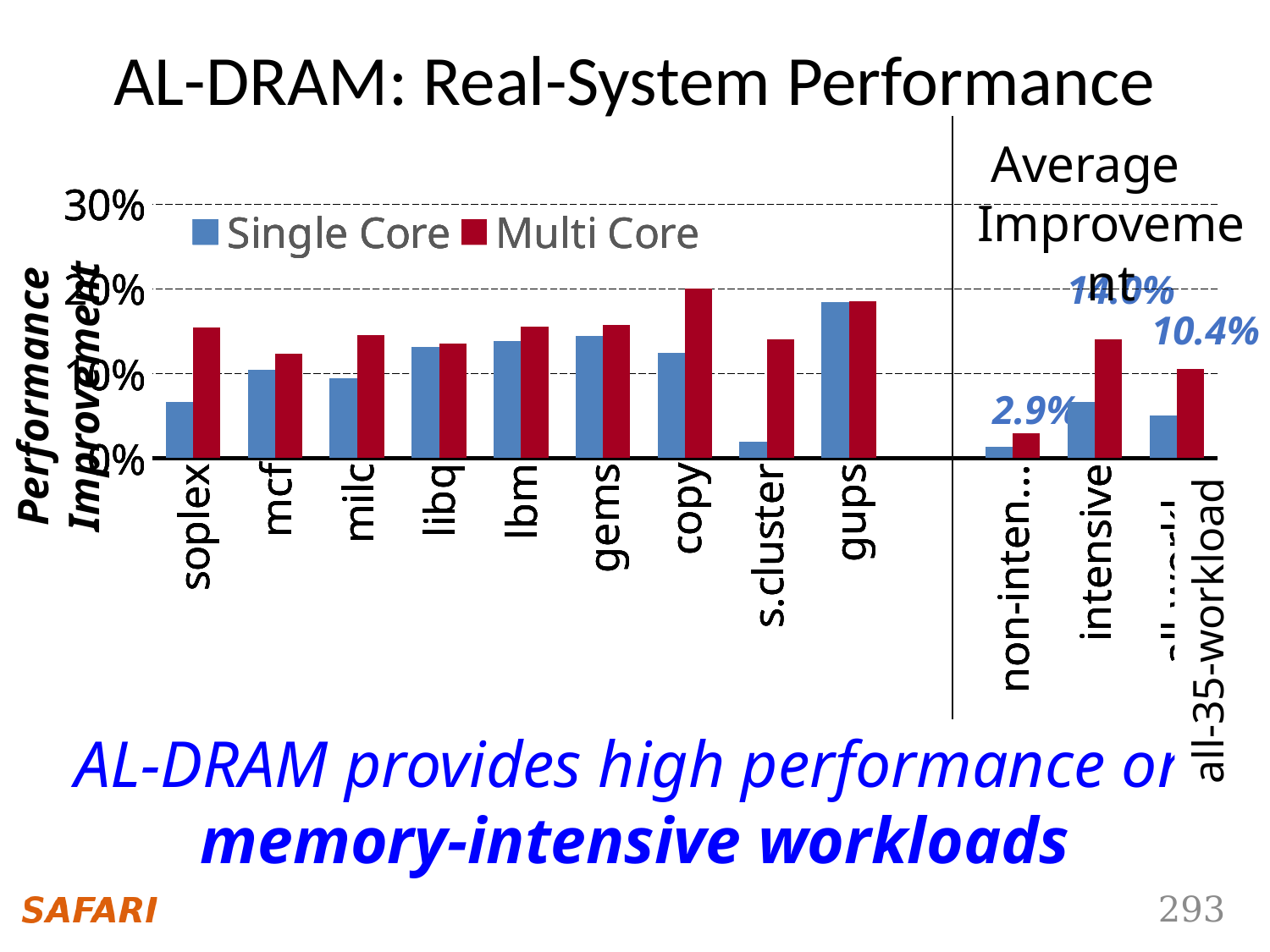
How many series does the legend list? 2 Which benchmark has the highest Single Core performance improvement? gups How many bar groups (categories) are plotted along the x axis? 12 What is the labelled average Multi Core improvement for all-35-workload? 10.4% For s.cluster, which is larger: the Single Core or the Multi Core improvement? Multi Core What kind of chart is shown on the slide? bar chart Which benchmark has the highest Multi Core performance improvement? copy What is the labelled average Multi Core improvement for the intensive workloads? 14.0% Is the Single Core value for soplex greater or less than 10%? less What are the two series named in the legend? Single Core and Multi Core Is the Multi Core value for copy greater or less than 10%? greater Among the nine individual benchmarks left of the divider, which has the lowest Single Core performance improvement? s.cluster